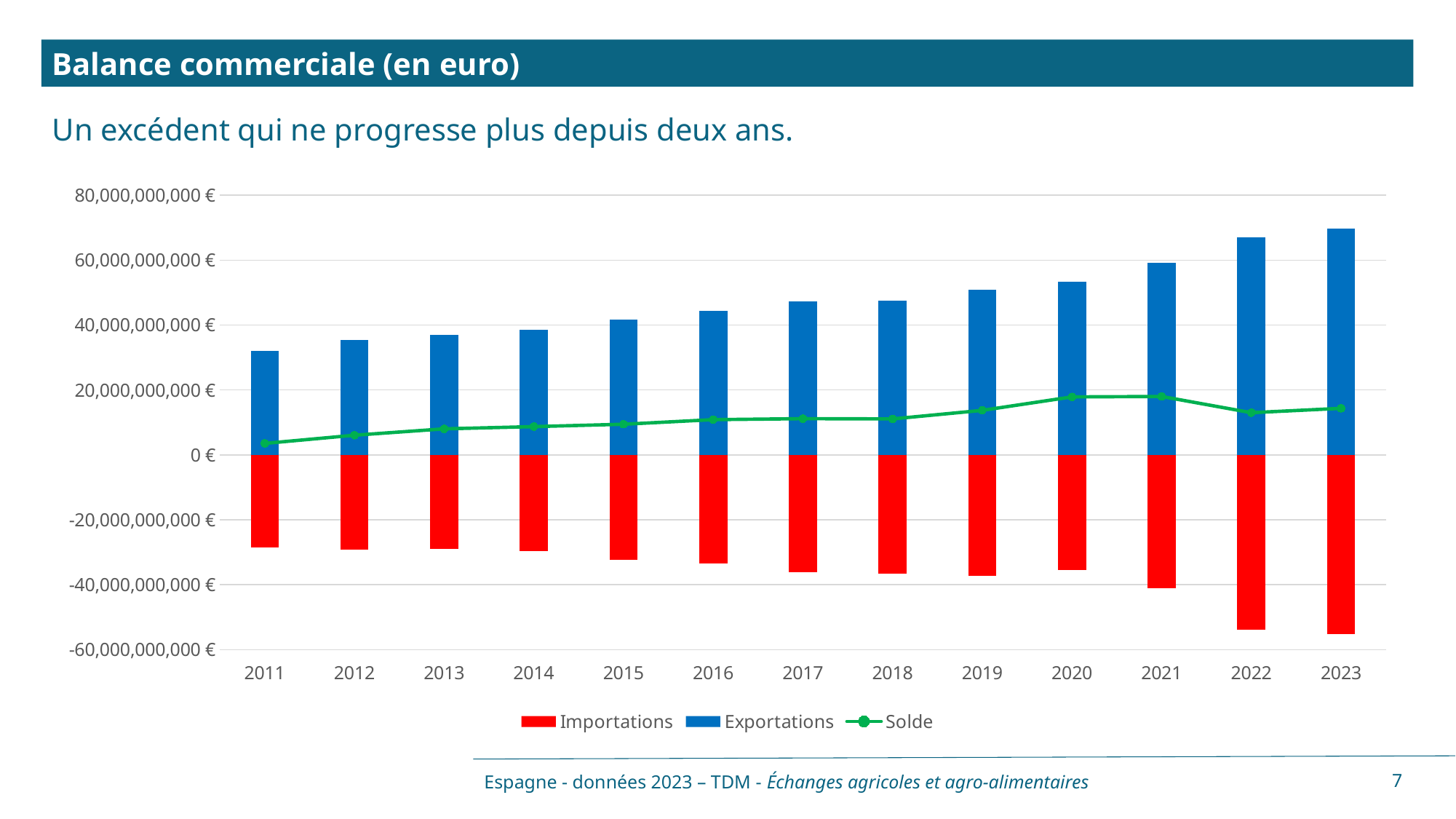
What kind of chart is shown on the slide? bar chart with a line Is the value for Solde in 2020 greater or less than 20,000,000,000 €? less Is the value for Exportations in 2023 greater or less than 60,000,000,000 €? greater Which year has the lowest Solde value? 2011 Do the Exportations values rise or fall from 2011 to 2023? rise How many series does the legend list? 3 Which is larger, the Exportations value for 2021 or for 2016? 2021 Which year has the lowest Exportations value? 2011 Is the value for Exportations in 2011 greater or less than 40,000,000,000 €? less Which year has the highest Exportations value? 2023 How many years are shown on the x axis? 13